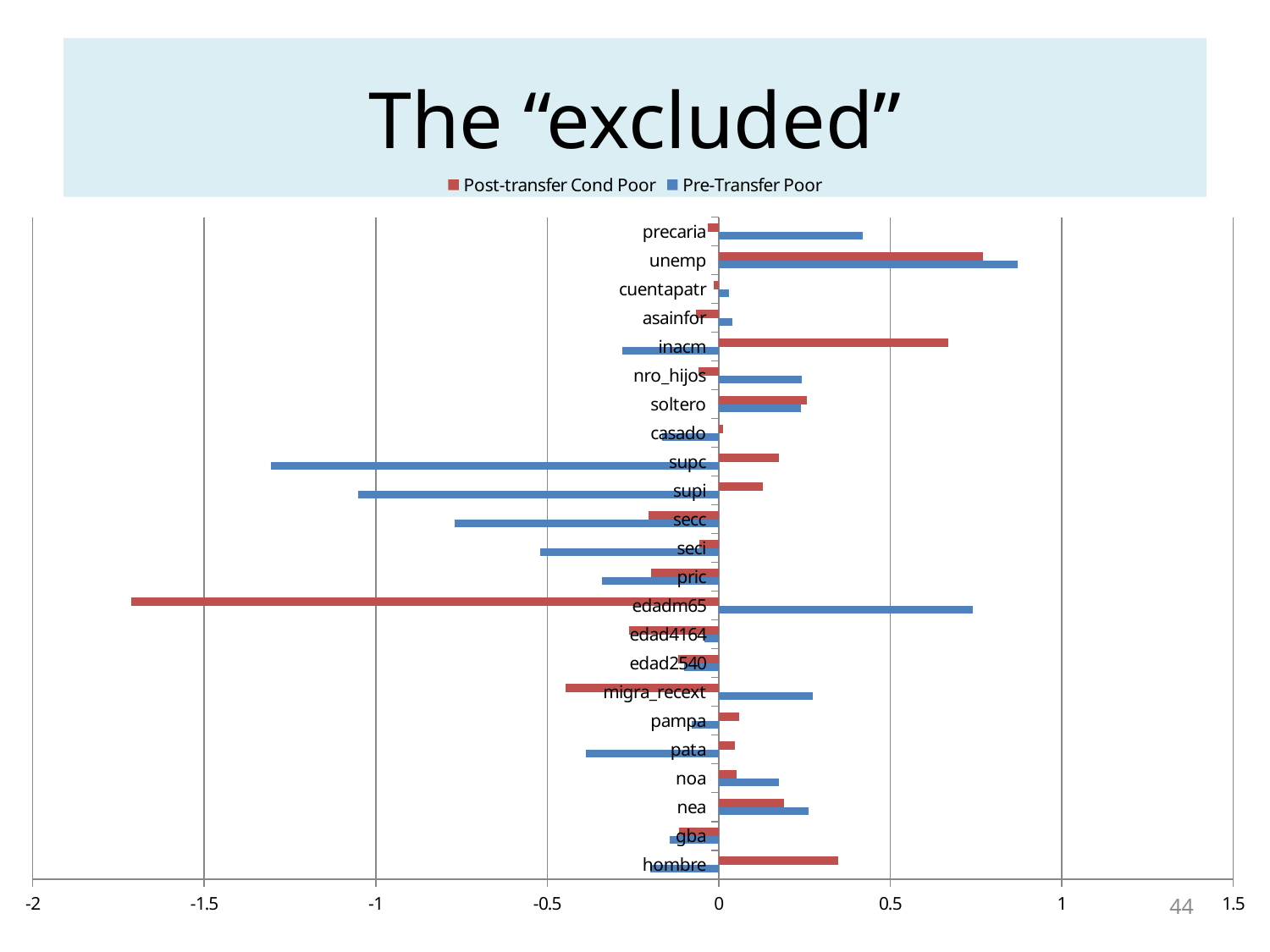
Which category has the lowest Pre-Transfer Poor value? supc Which category has the lowest Post-transfer Cond Poor value? edadm65 For edadm65, which series has the larger value, Post-transfer Cond Poor or Pre-Transfer Poor? Pre-Transfer Poor Is the Pre-Transfer Poor value for supc greater or less than -1? less Which category has the highest Pre-Transfer Poor value? unemp Which colour represents the Post-transfer Cond Poor series? red How many categories are plotted on the chart? 23 Is the Post-transfer Cond Poor value for edadm65 greater or less than -1.5? less Is the Post-transfer Cond Poor value for inacm greater or less than 0.5? greater How many series does the legend list? 2 What kind of chart is shown on the slide? bar chart